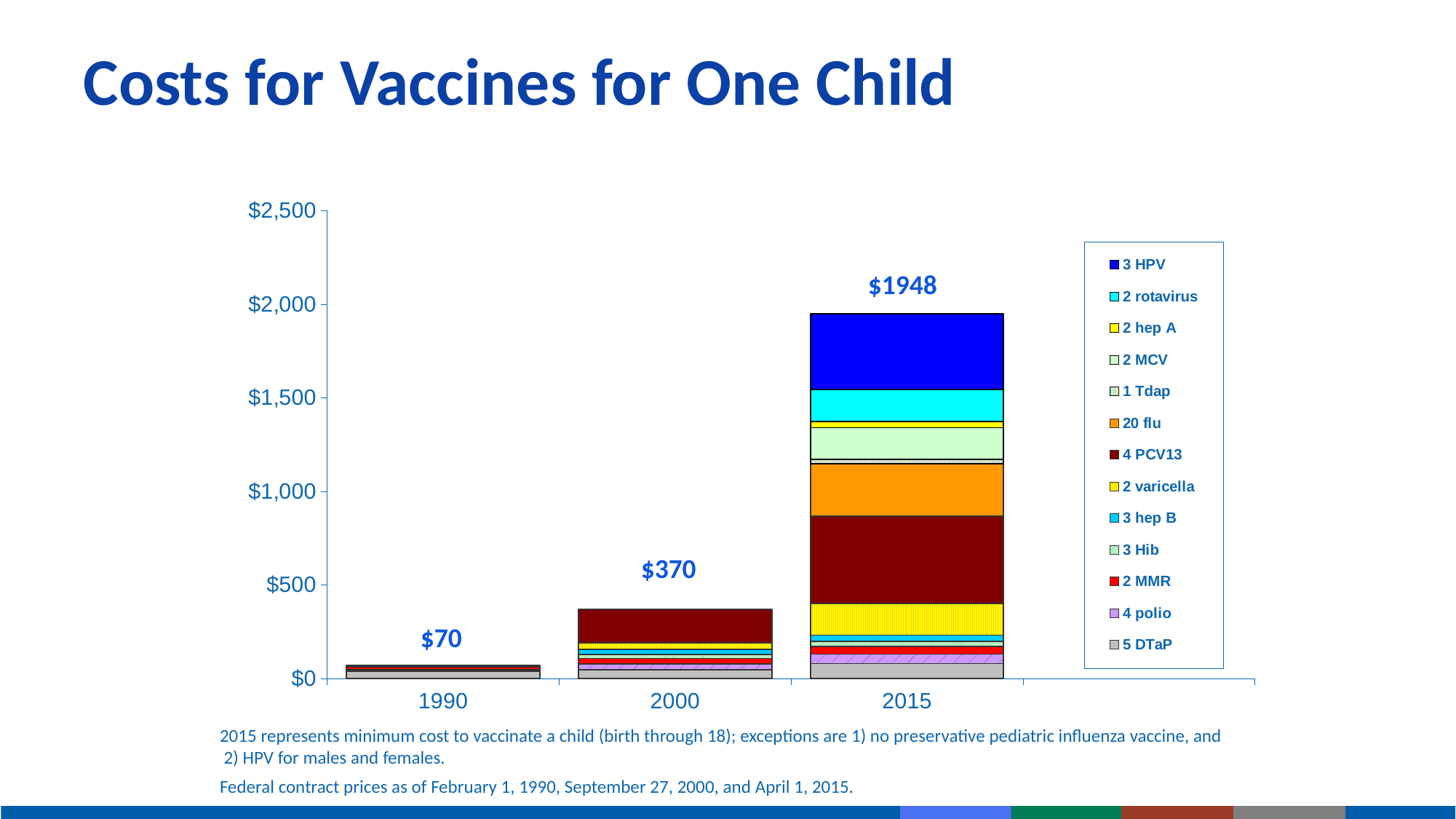
What is the total cost for vaccines for one child in 2015? $1948 How many vaccine series does the legend list? 13 What is the difference between the total cost in 2015 and the total cost in 2000? $1578 Which year has the highest total vaccine cost? 2015 Is the total cost in 2000 greater or less than $500? less What is the total cost for vaccines for one child in 2000? $370 How many years are shown on the x axis? 3 What is the total cost for vaccines for one child in 1990? $70 Which year has the lowest total vaccine cost? 1990 Do the total vaccine costs rise or fall from 1990 to 2015? Rise What kind of chart is shown on the slide? Stacked bar chart What is the difference between the total cost in 2000 and the total cost in 1990? $300